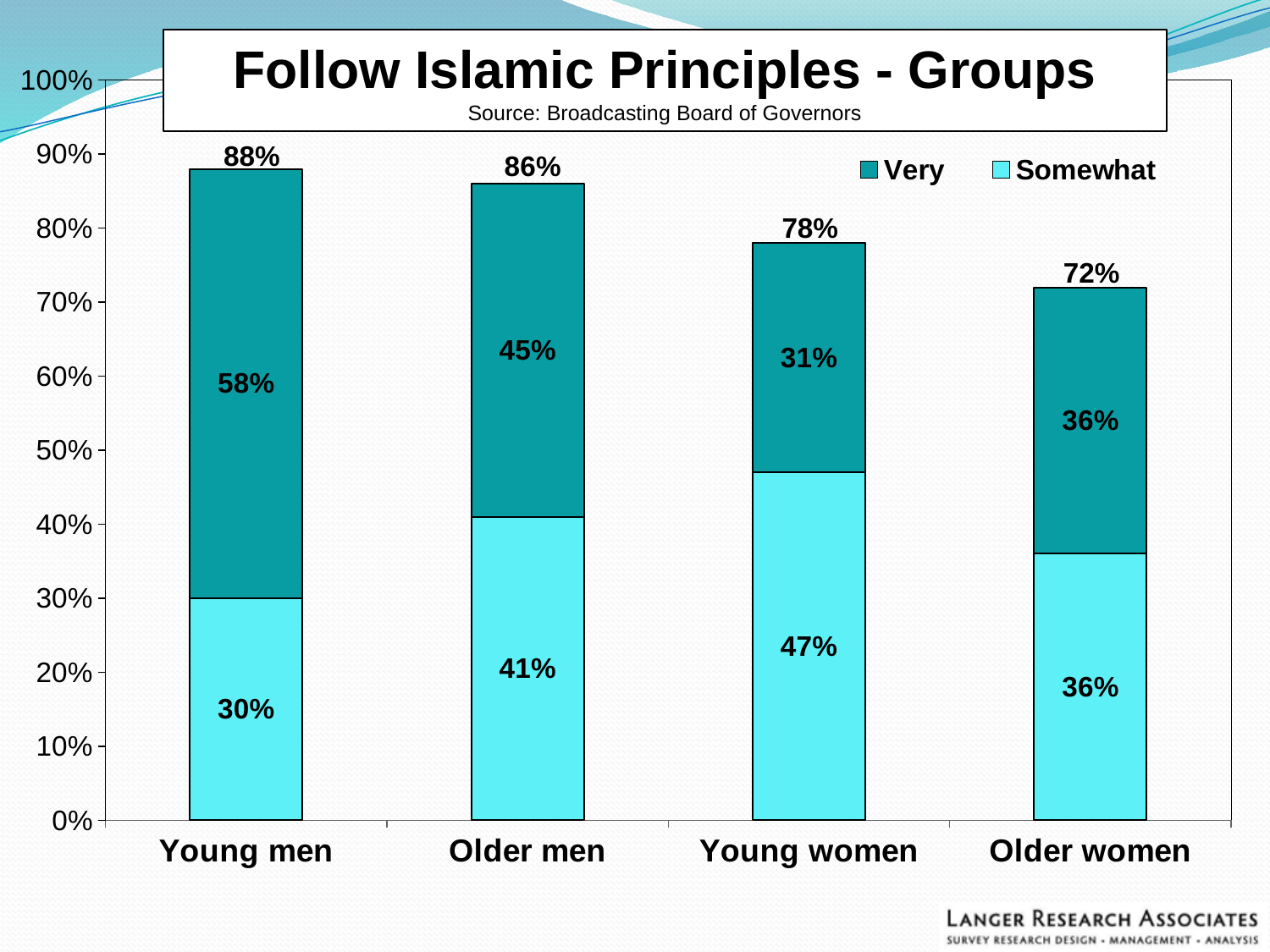
How many groups are shown on the x axis? 4 What is the 'Somewhat' value for Older men? 41% What is the total of the stacked bar for Older men? 86% Which is larger: the 'Somewhat' value for Young women or the 'Somewhat' value for Older women? Young women What is the 'Somewhat' value for Young women? 47% How many series does the legend list? 2 What is the difference between the 'Very' values for Young men and Young women? 27% What kind of chart is shown? Stacked bar chart Which group has the highest total bar? Young men Which group has the lowest total bar? Older women What is the 'Very' value for Young men? 58% What is the source cited under the chart title? Broadcasting Board of Governors